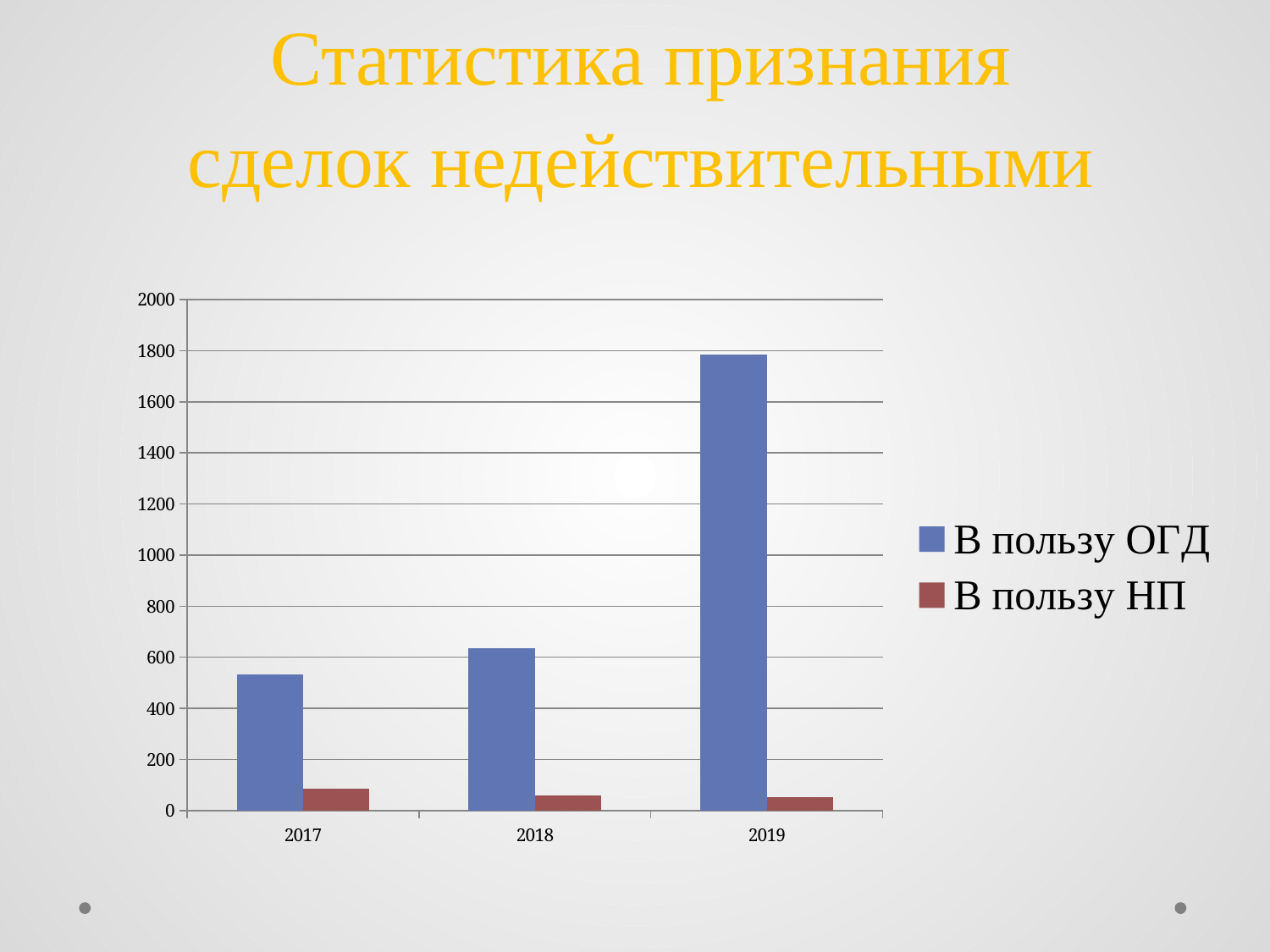
Is the value for "В пользу ОГД" in 2019 greater or less than 1600? greater Does the value for "В пользу ОГД" rise or fall from 2017 to 2019? rise In which year is the value for "В пользу НП" the highest? 2017 How many series does the legend list? 2 What kind of chart is shown on the slide? bar chart In which year is the value for "В пользу ОГД" the highest? 2019 Is the value for "В пользу ОГД" in 2018 greater or less than 800? less Is the value for "В пользу НП" in 2017 greater or less than 200? less In which year is the value for "В пользу ОГД" the lowest? 2017 Which is larger in 2018: the value for "В пользу ОГД" or the value for "В пользу НП"? В пользу ОГД How many years are shown on the x axis? 3